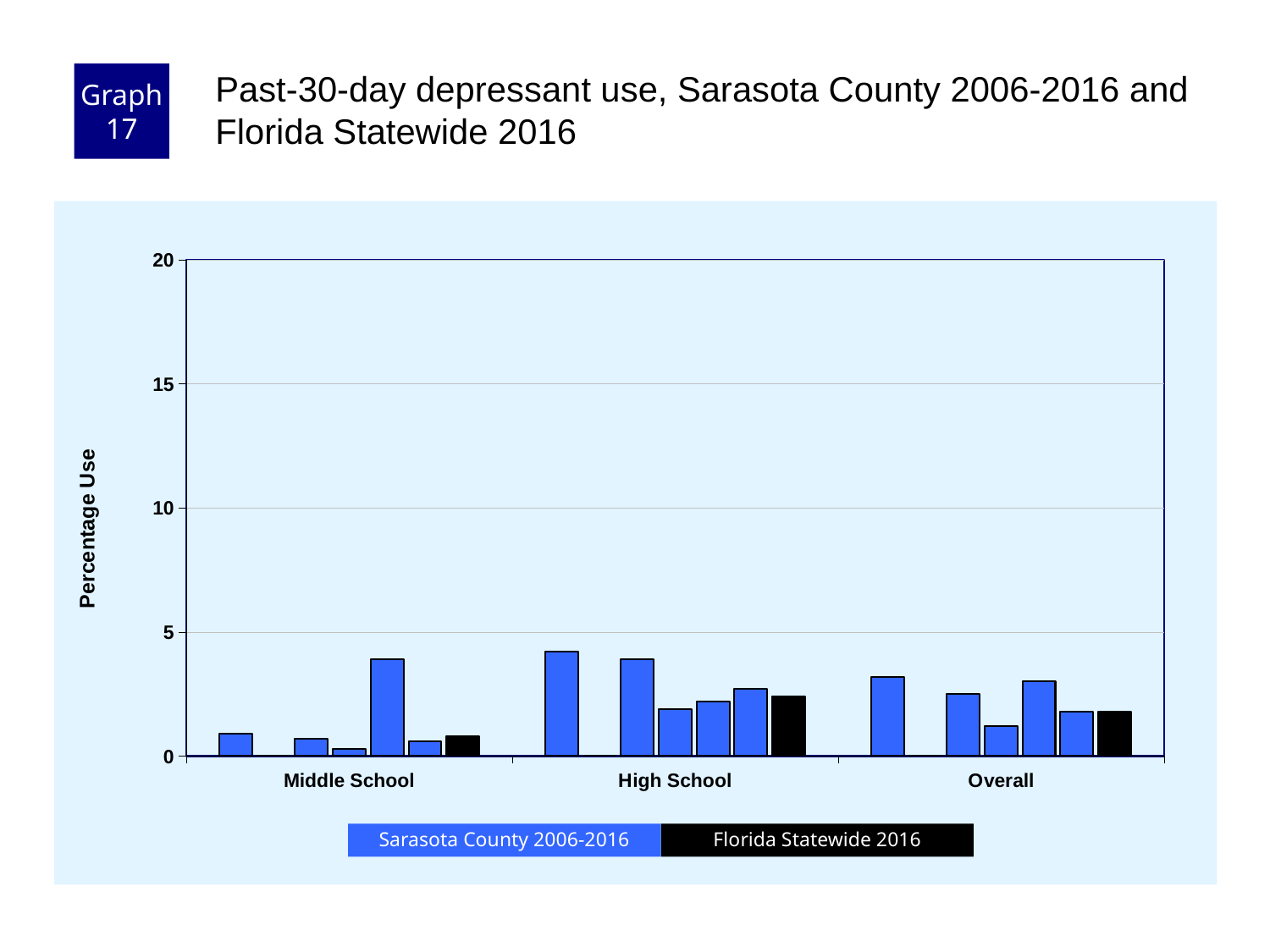
How many series does the legend list? 2 Which category group contains the tallest bar on the chart? High School What kind of chart is shown on the slide? bar chart Which is larger, the Florida Statewide 2016 value for Overall or for Middle School? Overall How many category groups are shown along the x axis? 3 Which is larger, the Florida Statewide 2016 value for High School or for Middle School? High School Is the Florida Statewide 2016 value for High School greater or less than 5? less Which colour represents Florida Statewide 2016 in the legend? black What is the label on the y axis? Percentage Use Which category group has the lowest Florida Statewide 2016 value? Middle School Is the tallest Sarasota County 2006-2016 bar in the High School group greater or less than 5? less Is the Florida Statewide 2016 value for Middle School greater or less than 5? less